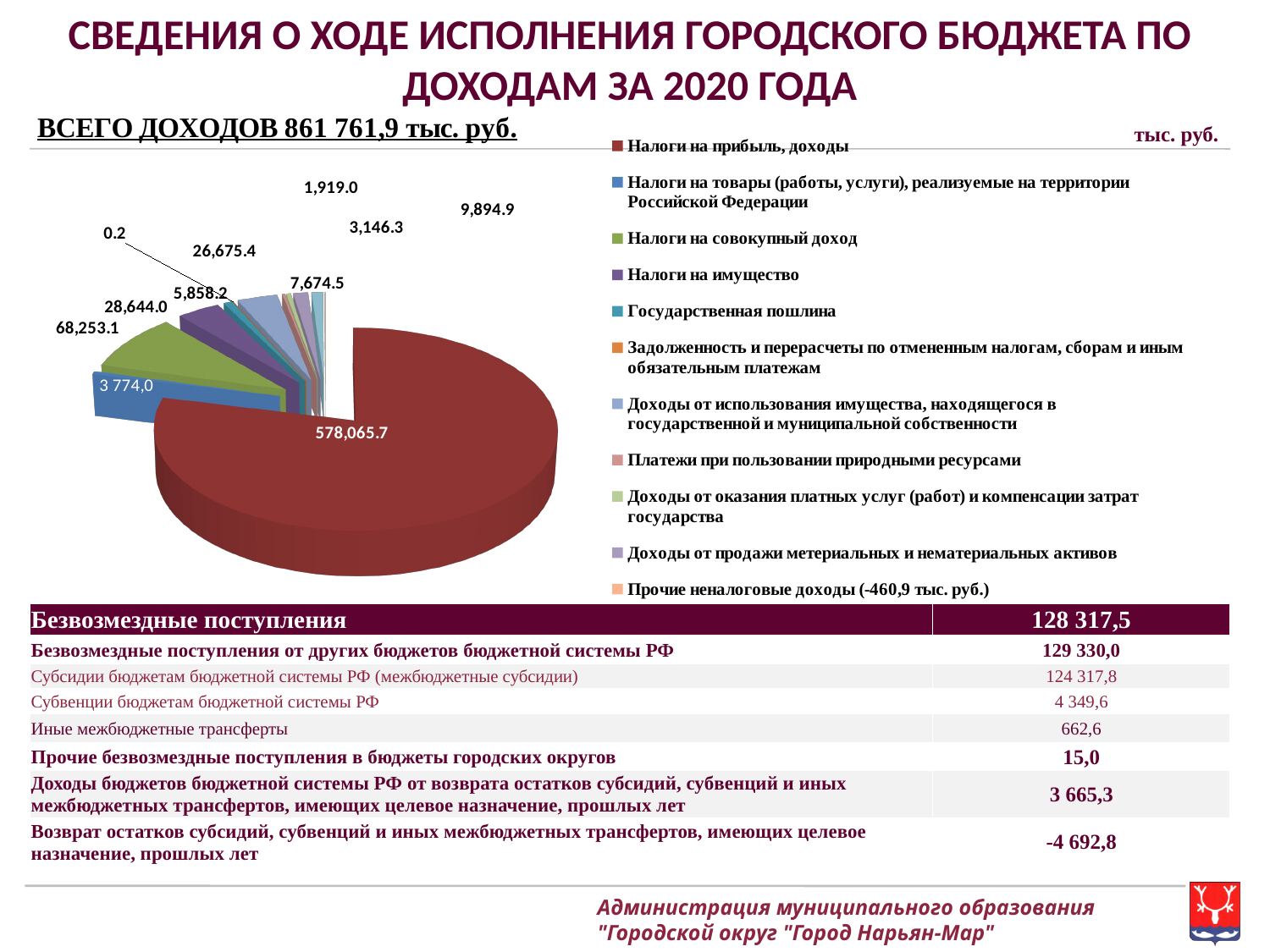
Which legend entry corresponds to the largest (dark red) slice of the pie chart? Налоги на прибыль, доходы In what units are the values of the pie chart given, according to the label at the top right of the chart? тыс. руб. What is the difference between the slice labelled 578,065.7 and the slice labelled 68,253.1? 509,812.6 What is the value of the green slice labelled for 'Налоги на совокупный доход'? 68,253.1 What is the value of the largest slice in the pie chart? 578,065.7 How many entries does the legend of the pie chart list? 11 What is the value of the blue slice for 'Налоги на товары (работы, услуги), реализуемые на территории Российской Федерации'? 3 774,0 What is the smallest data label shown on the pie chart? 0.2 How many data labels are shown on the pie chart? 11 What kind of chart is shown on the slide? pie chart What is the difference between the slice labelled 28,644.0 and the slice labelled 26,675.4? 1,968.6 Which is larger in the pie chart: the slice labelled 68,253.1 or the slice labelled 28,644.0? 68,253.1